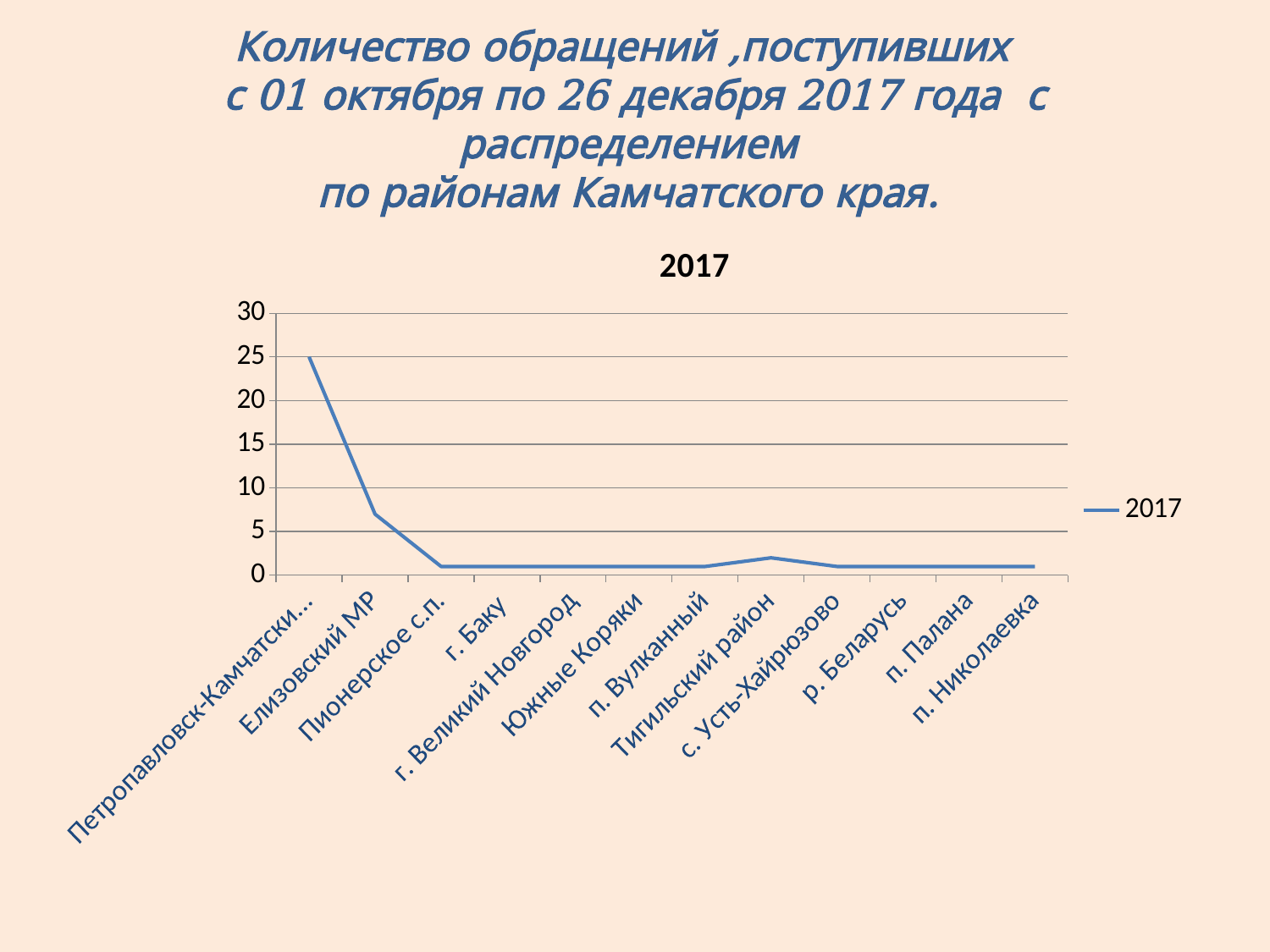
Which category has the highest value? Петропавловск-Камчатски... How many series does the legend list? 1 How many categories are plotted along the x axis? 12 What is the title shown directly above the chart? 2017 Is the value for Петропавловск-Камчатски... greater or less than 20? greater What kind of chart is shown on the slide? line chart Is the value for Елизовский МР greater or less than 5? greater Is the value for Елизовский МР greater or less than 10? less Which is larger, the value for Петропавловск-Камчатски... or the value for Елизовский МР? Петропавловск-Камчатски... Do the values generally rise or fall moving from left to right along the x axis? fall Which is larger, the value for Елизовский МР or the value for Тигильский район? Елизовский МР